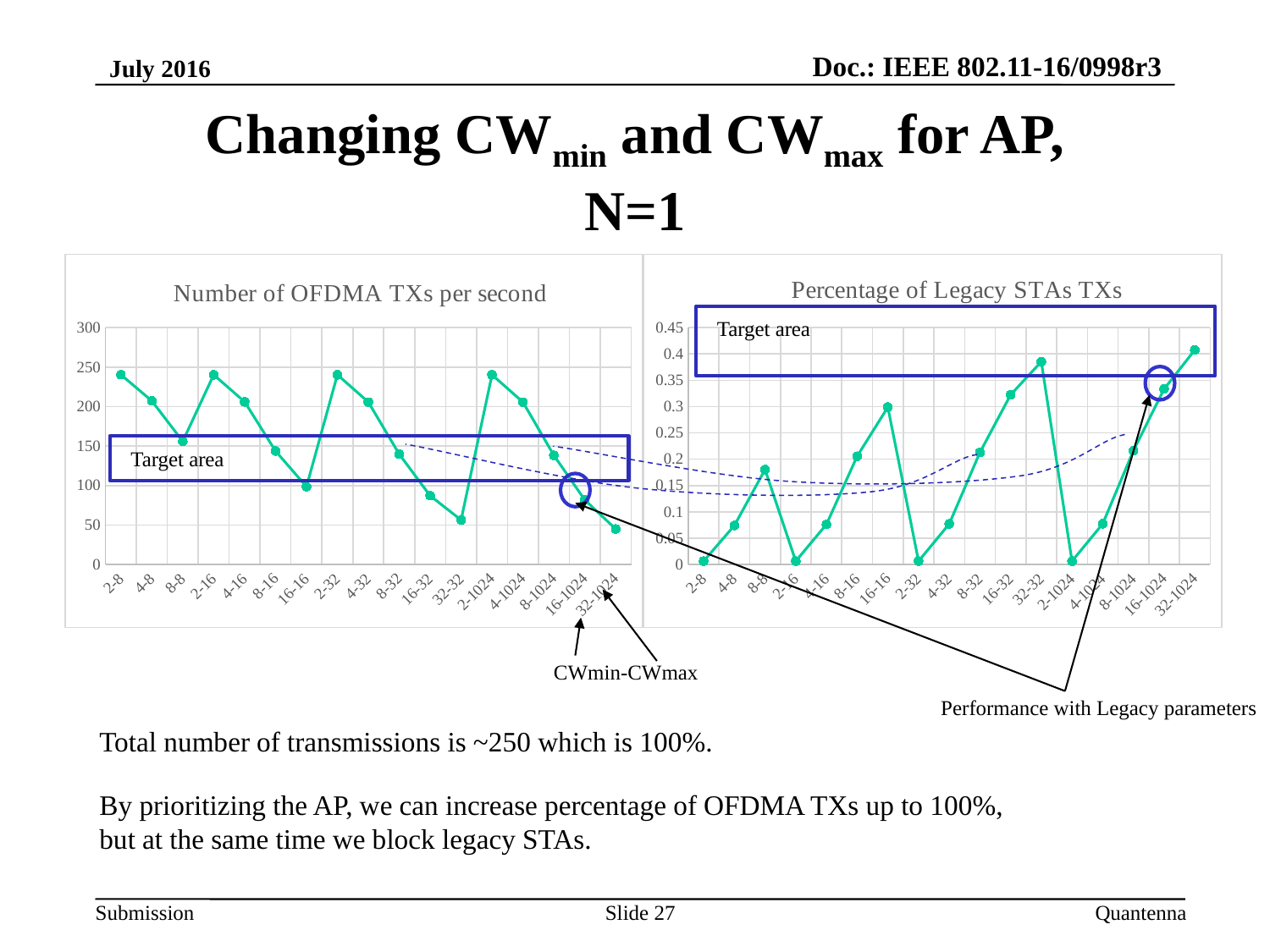
In the right chart, 'Percentage of Legacy STAs TXs', which is larger, the value for 32-32 or the value for 2-1024? 32-32 In the right chart, 'Percentage of Legacy STAs TXs', is the value for 4-32 greater or less than 0.1? less In the left chart, 'Number of OFDMA TXs per second', is the value for 2-8 greater or less than 200? greater In the left chart, 'Number of OFDMA TXs per second', which is larger, the value for 2-8 or the value for 32-32? 2-8 What type of chart is the left chart, 'Number of OFDMA TXs per second'? line chart In the right chart, 'Percentage of Legacy STAs TXs', is the value for 32-32 greater or less than 0.35? greater How many categories are shown on the x axis of the left chart, 'Number of OFDMA TXs per second'? 17 What is the title of the right chart? Percentage of Legacy STAs TXs What label is written inside the blue rectangle drawn on each chart? Target area